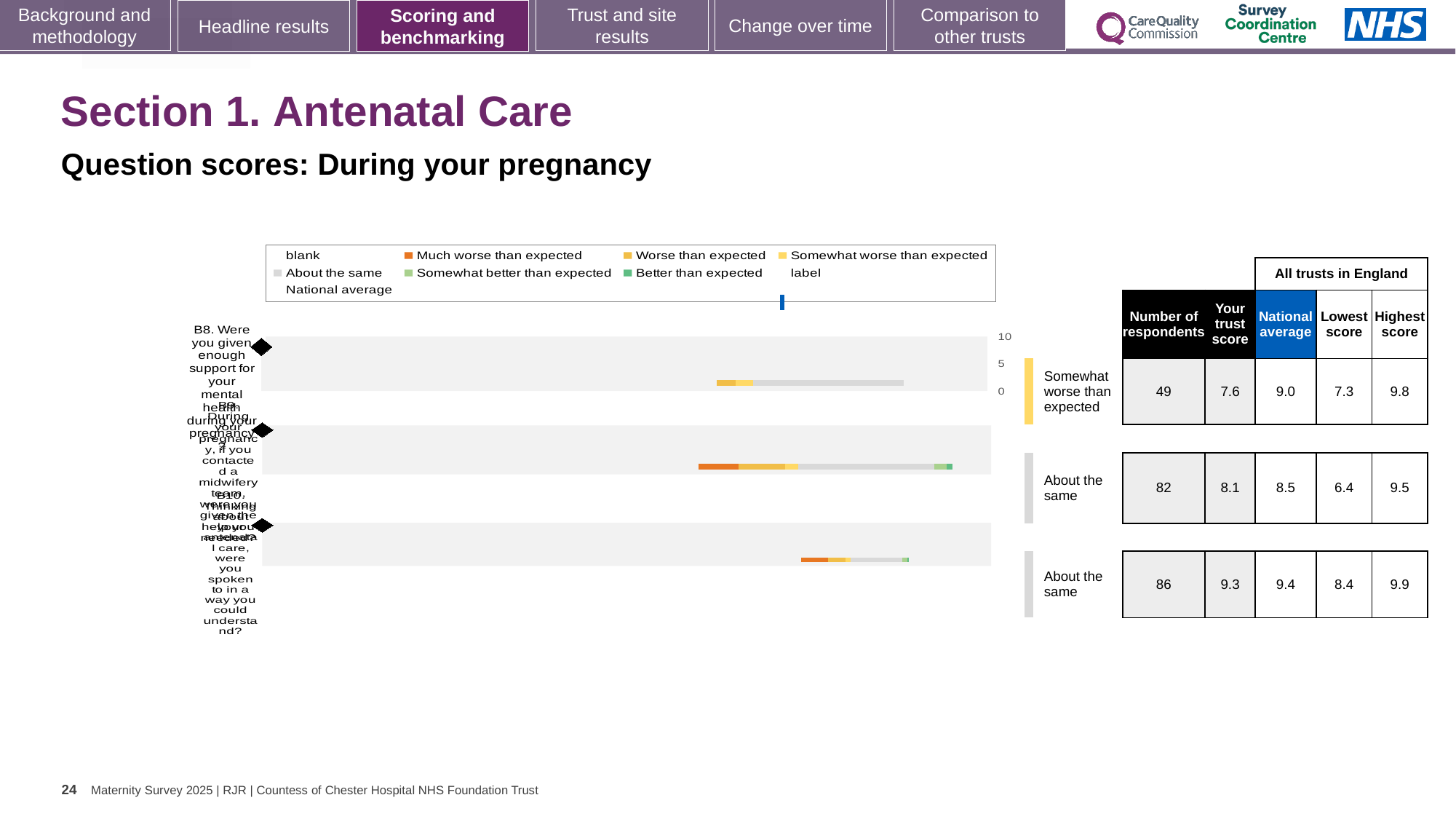
In the table beside the chart, which row has the highest number of respondents? the third row (B10), 86 In the table beside the chart, what is the difference between the national average and the trust score for the first row (B8)? 1.4 What colour does the legend use for 'About the same'? grey What kind of chart is shown on the slide? bar chart In the table beside the chart, what is the trust score for the first row (B8)? 7.6 What colour does the legend use for 'National average'? blue In the table beside the chart, what is the national average for the third row (B10)? 9.4 How many entries does the chart legend list? 9 What rating label is shown beside the third bar (B10)? About the same How many question bars are plotted in the chart? 3 What rating label is shown beside the first bar (B8, support for mental health during pregnancy)? Somewhat worse than expected What is the highest tick value shown on the chart's axis? 10